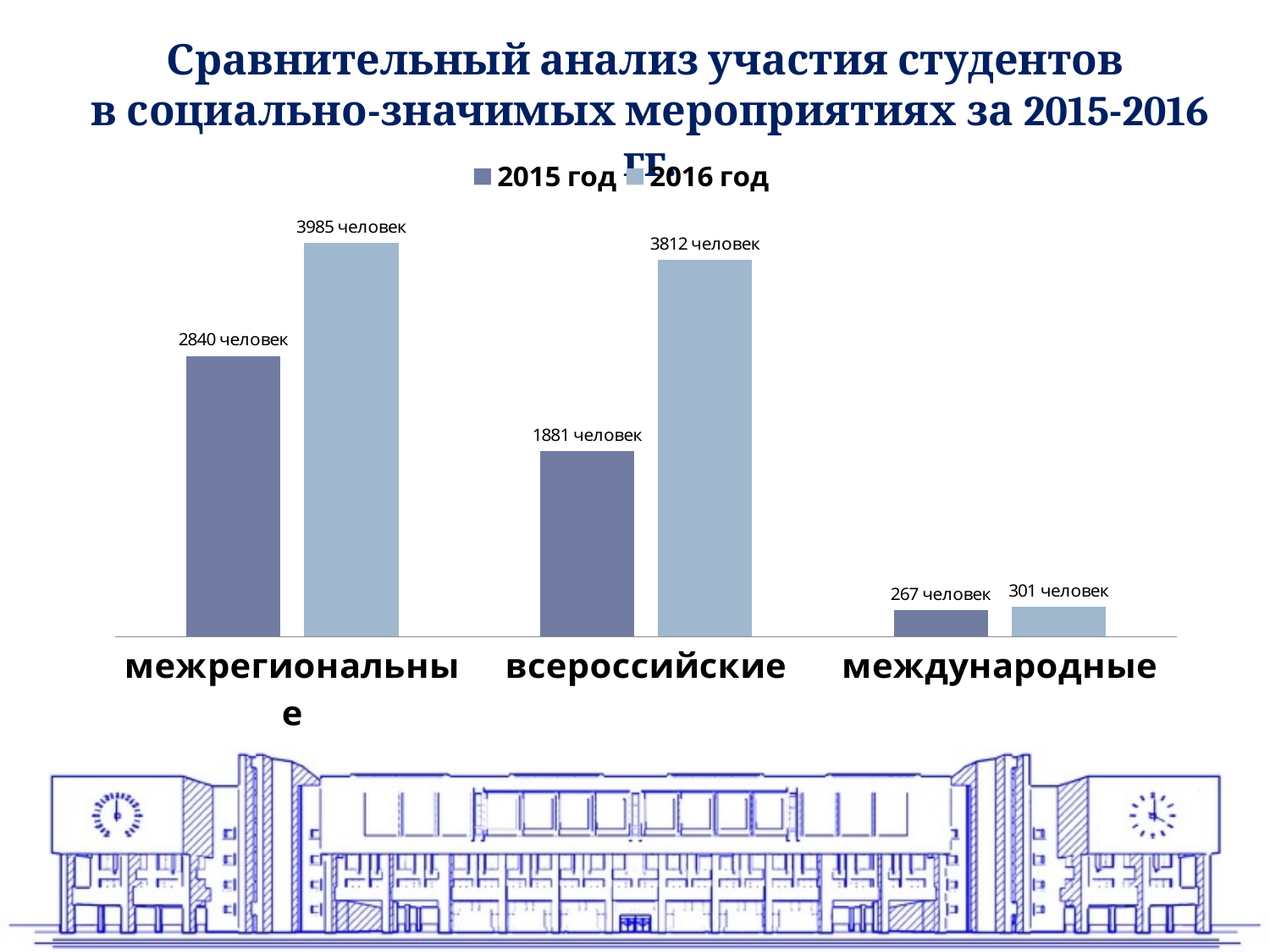
Which is larger: the 2015 год value for межрегиональные or the 2016 год value for всероссийские? 2016 год value for всероссийские What is the value for межрегиональные in the 2015 год series? 2840 человек Which category has the lowest value in the 2015 год series? международные What is the value for международные in the 2015 год series? 267 человек What kind of chart is shown on the slide? bar chart What is the difference between the 2016 год and 2015 год values for всероссийские? 1931 человек What is the value for всероссийские in the 2016 год series? 3812 человек What are the two series named in the legend? 2015 год and 2016 год How many categories are shown on the x axis? 3 Which category has the highest value in the 2016 год series? межрегиональные How many series does the legend list? 2 What is the difference between the 2016 год and 2015 год values for межрегиональные? 1145 человек